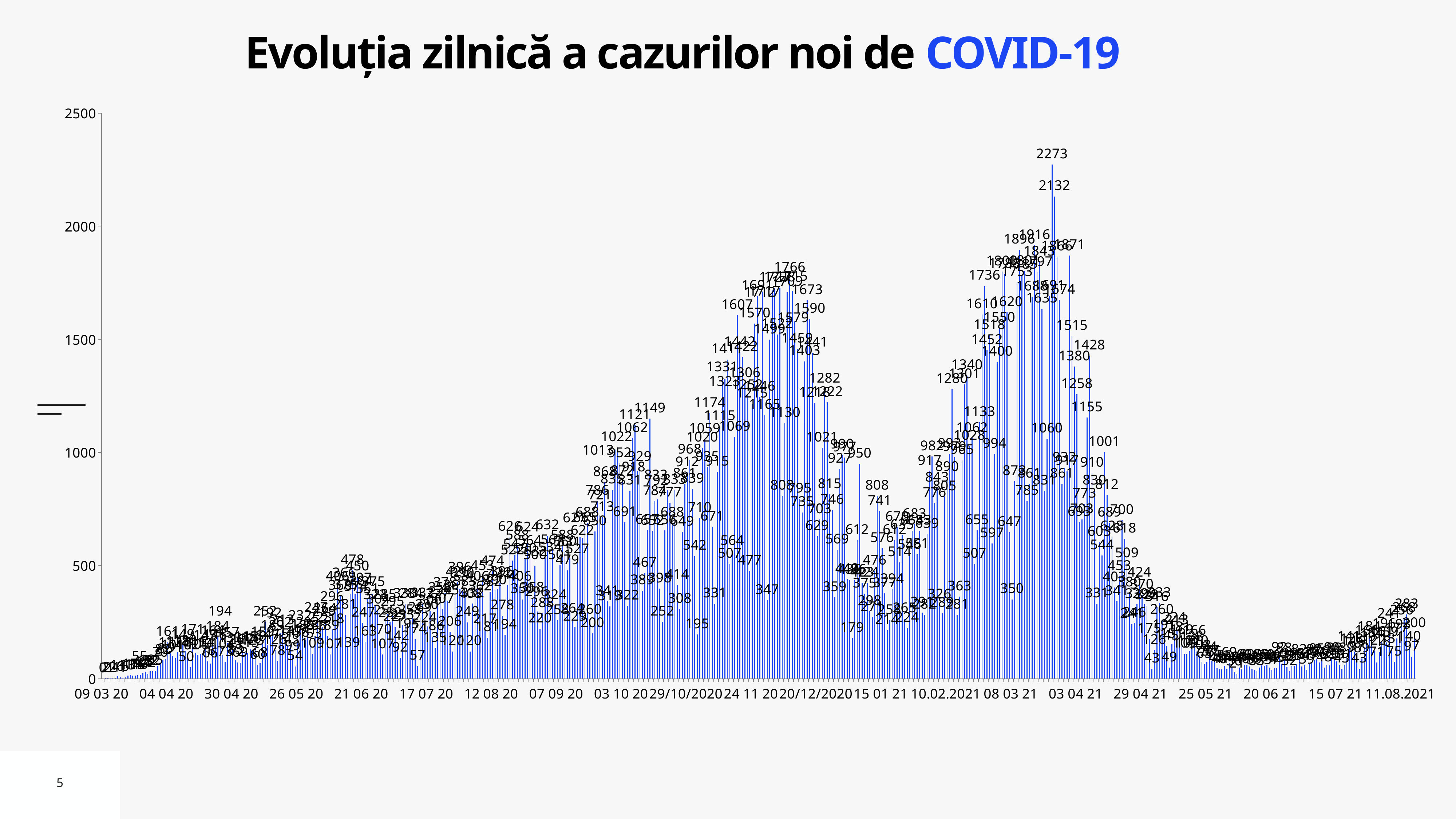
What is the maximum value shown on the vertical axis? 2500 What is the first date label on the horizontal axis? 09 03 20 Is the value around 20 06 21 greater or less than 500? less Is the highest bar on the chart greater or less than 2000? greater Is the value at the last date shown, 11.08.2021, greater or less than 500? less Which peak is larger: the one around 03 04 21 or the one around 24 11 20? the one around 03 04 21 What kind of chart is shown on the slide? bar chart What is the difference between the two highest labelled values, 2273 and 2132? 141 What is the title of the chart? Evoluția zilnică a cazurilor noi de COVID-19 What is the highest daily value labelled on the chart? 2273 What is the second highest value labelled on the chart, next to the 2273 peak? 2132 Do the values rise or fall between the peak around 03 04 21 and 20 06 21? fall